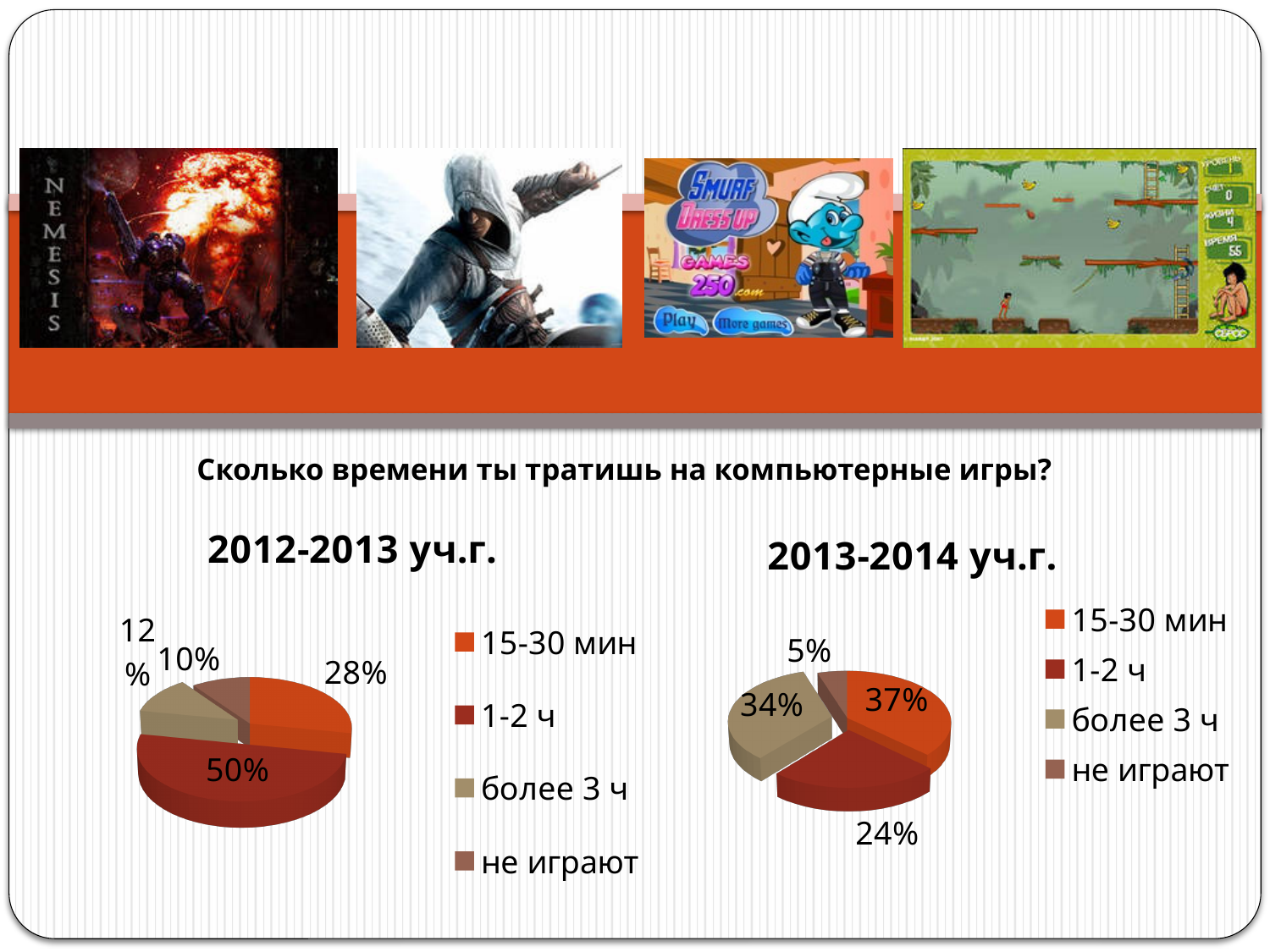
In the 2013-2014 уч.г. chart, what colour is the slice for 1-2 ч? dark red What kind of chart is the 2013-2014 уч.г. chart? pie chart In the 2012-2013 уч.г. chart, which is larger: the share for 15-30 мин or the share for более 3 ч? 15-30 мин In the 2013-2014 уч.г. chart, which category has the smallest slice? не играют In the 2013-2014 уч.г. chart, what share is labelled for более 3 ч? 34% In the 2012-2013 уч.г. chart, which category has the largest slice? 1-2 ч In the 2012-2013 уч.г. chart, what share is labelled for 1-2 ч? 50% In the 2013-2014 уч.г. chart, what is the difference between the 15-30 мин share and the 1-2 ч share? 13% In the 2012-2013 уч.г. chart, which category has the smallest slice? не играют How many categories does the legend of the 2012-2013 уч.г. chart list? 4 What is the question written above the two charts? Сколько времени ты тратишь на компьютерные игры? In the 2013-2014 уч.г. chart, what share is labelled for 15-30 мин? 37%